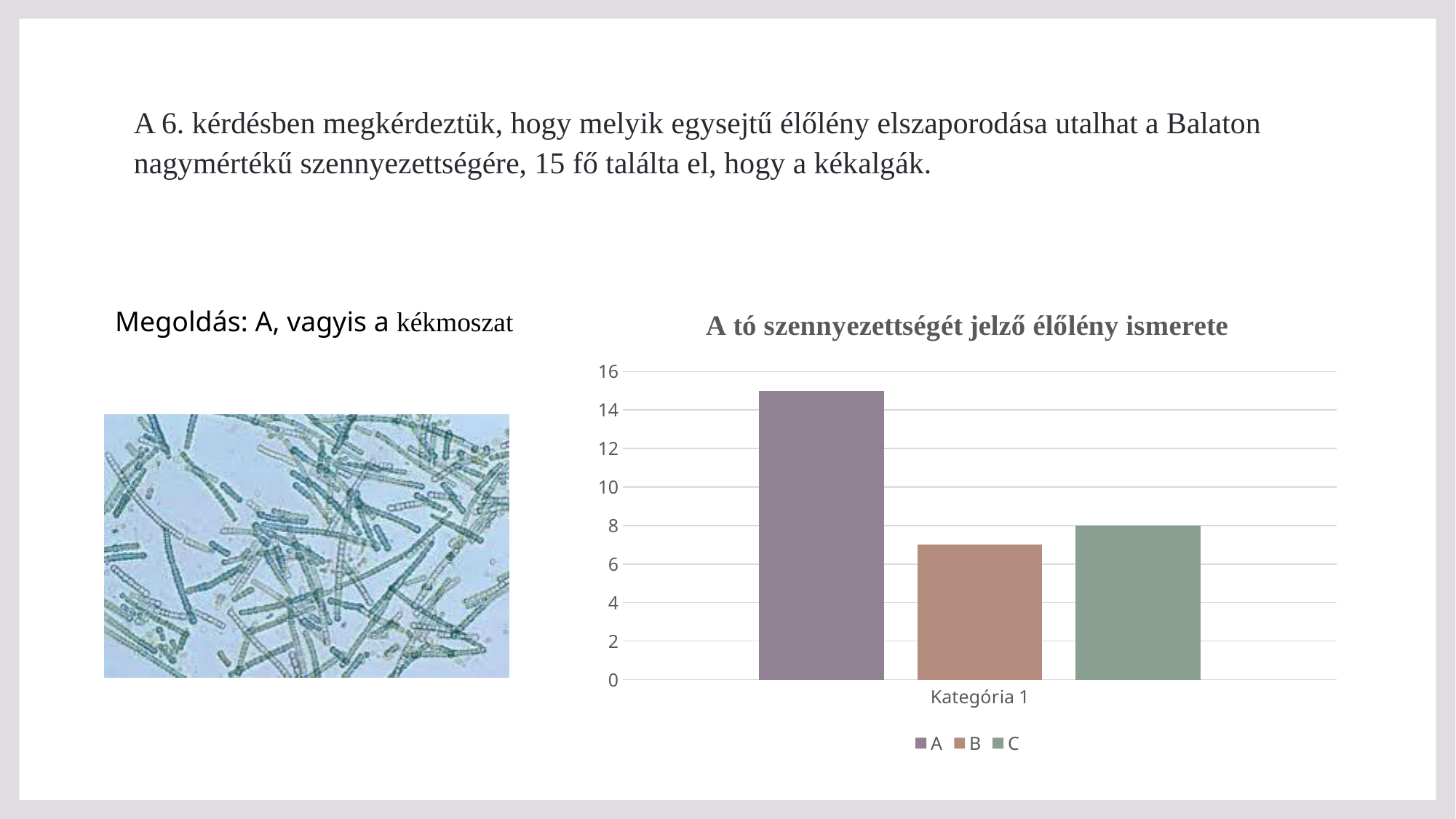
How many categories are shown on the x axis of the chart? 1 Which series has the lowest bar in the chart? B Which series has the highest bar in the chart? A How many series does the legend of the chart list? 3 Is the value for series A greater or less than 14? greater What is the value of series A in the chart? 15 What is the category label shown on the x axis of the chart? Kategória 1 Which is larger in the chart, series B or series C? C What is the title of the chart? A tó szennyezettségét jelző élőlény ismerete What kind of chart is shown on the slide? bar chart What is the value of series C in the chart? 8 Is the value for series B greater or less than 8? less